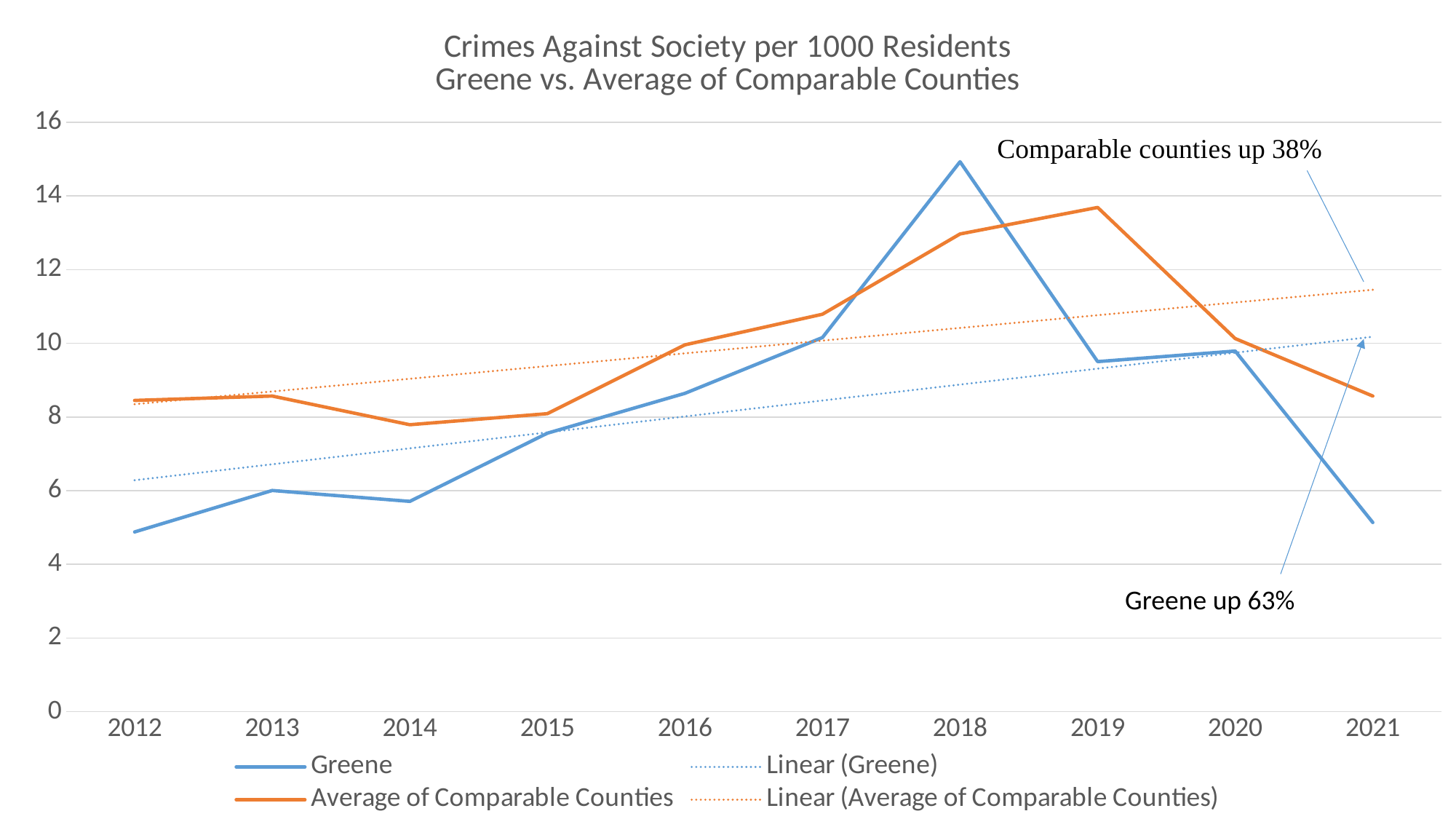
Is the Greene value for 2021 greater or less than 6? less In 2021, which series has the higher value, Greene or Average of Comparable Counties? Average of Comparable Counties According to the annotation on the chart, by what percentage is Greene up? 63% Is the Average of Comparable Counties value for 2019 greater or less than 12? greater How many years are plotted along the x axis? 10 In which year does the Greene series reach its highest value? 2018 Is the Greene value for 2018 greater or less than 14? greater In 2018, which series has the higher value, Greene or Average of Comparable Counties? Greene How many entries does the legend list? 4 In which year does the Average of Comparable Counties series reach its highest value? 2019 In which year is the Greene series at its lowest value? 2012 What kind of chart is shown on the slide? line chart